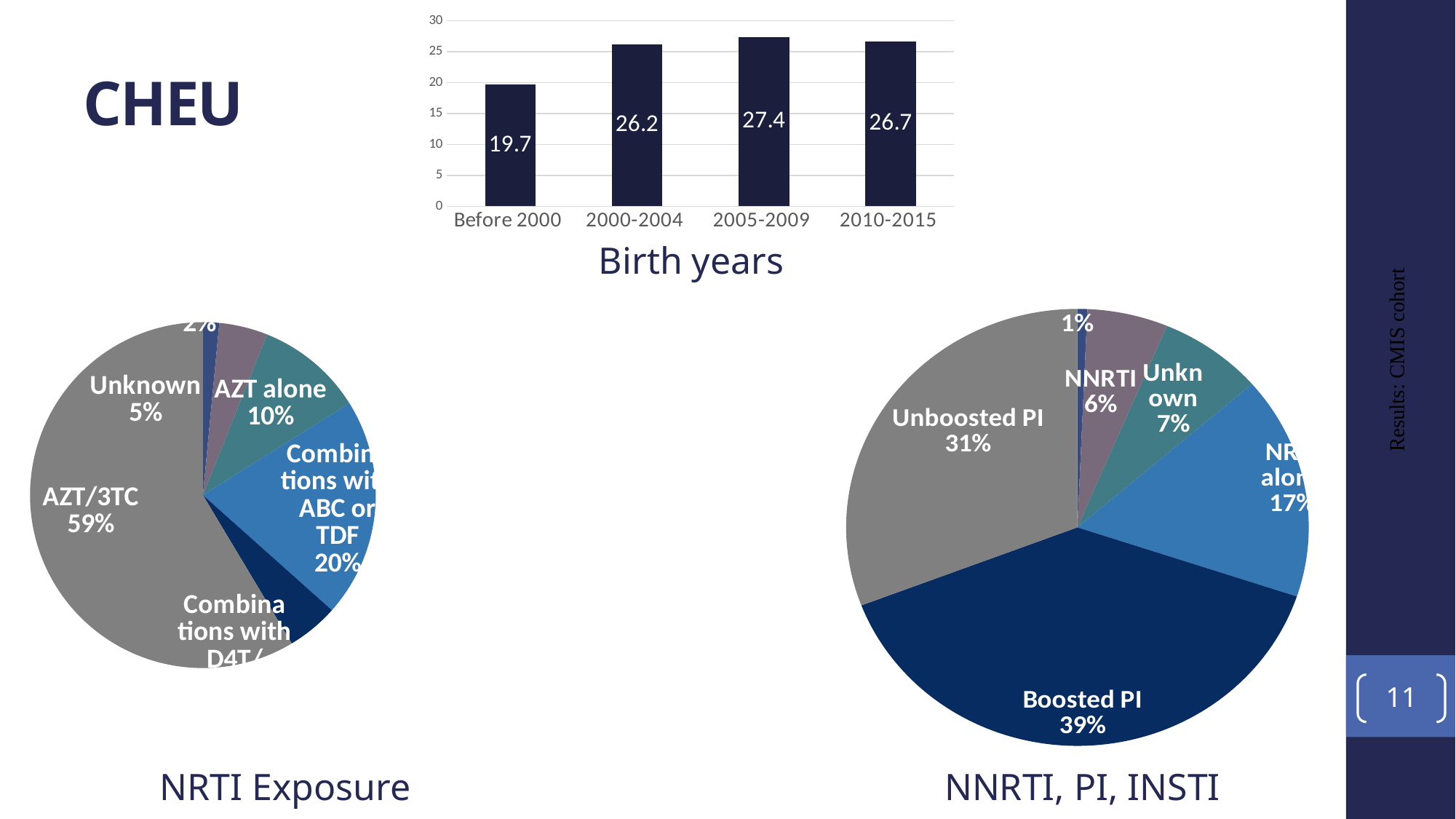
In the Birth years bar chart, what is the difference between the values for 2000-2004 and Before 2000? 6.5 In the NNRTI, PI, INSTI pie chart, what is the difference between the Boosted PI and Unboosted PI shares? 8% In the NNRTI, PI, INSTI pie chart, which is larger, Unboosted PI or NNRTI? Unboosted PI In the Birth years bar chart, what is the value for 2005-2009? 27.4 What type of chart is the Birth years chart at the top of the slide? Bar chart In the Birth years bar chart, which birth year group has the lowest value? Before 2000 In the Birth years bar chart, which birth year group has the highest value? 2005-2009 In the Birth years bar chart, how many birth year groups are shown? 4 In the NRTI Exposure pie chart, what share does AZT alone have? 10% In the Birth years bar chart, what is the value for Before 2000? 19.7 In the NRTI Exposure pie chart, what share does AZT/3TC have? 59% In the NNRTI, PI, INSTI pie chart, what share does Boosted PI have? 39%